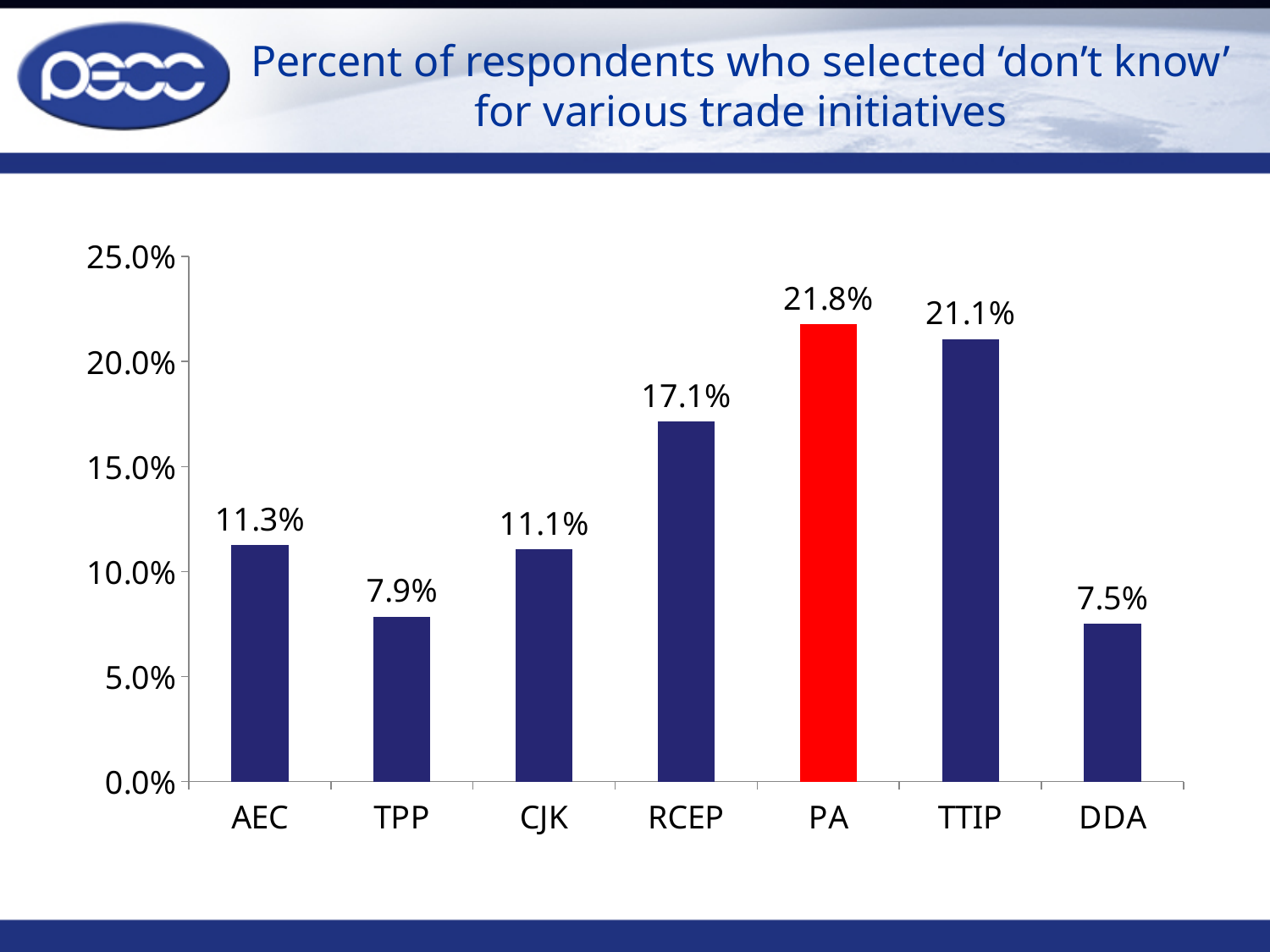
What is the value shown for AEC? 11.3% What is the value shown for TPP? 7.9% What is the difference between the values for PA and TTIP? 0.7% Is the value for TTIP greater or less than 20.0%? greater Which bar is coloured red instead of dark blue? PA How many trade initiatives are shown on the x axis? 7 Which trade initiative has the lowest percent of 'don't know' responses? DDA What kind of chart is shown on the slide? Bar chart Which is larger, the value for AEC or the value for CJK? AEC What percent of respondents selected 'don't know' for RCEP? 17.1% Which trade initiative has the highest percent of 'don't know' responses? PA What is the difference between the values for RCEP and CJK? 6.0%